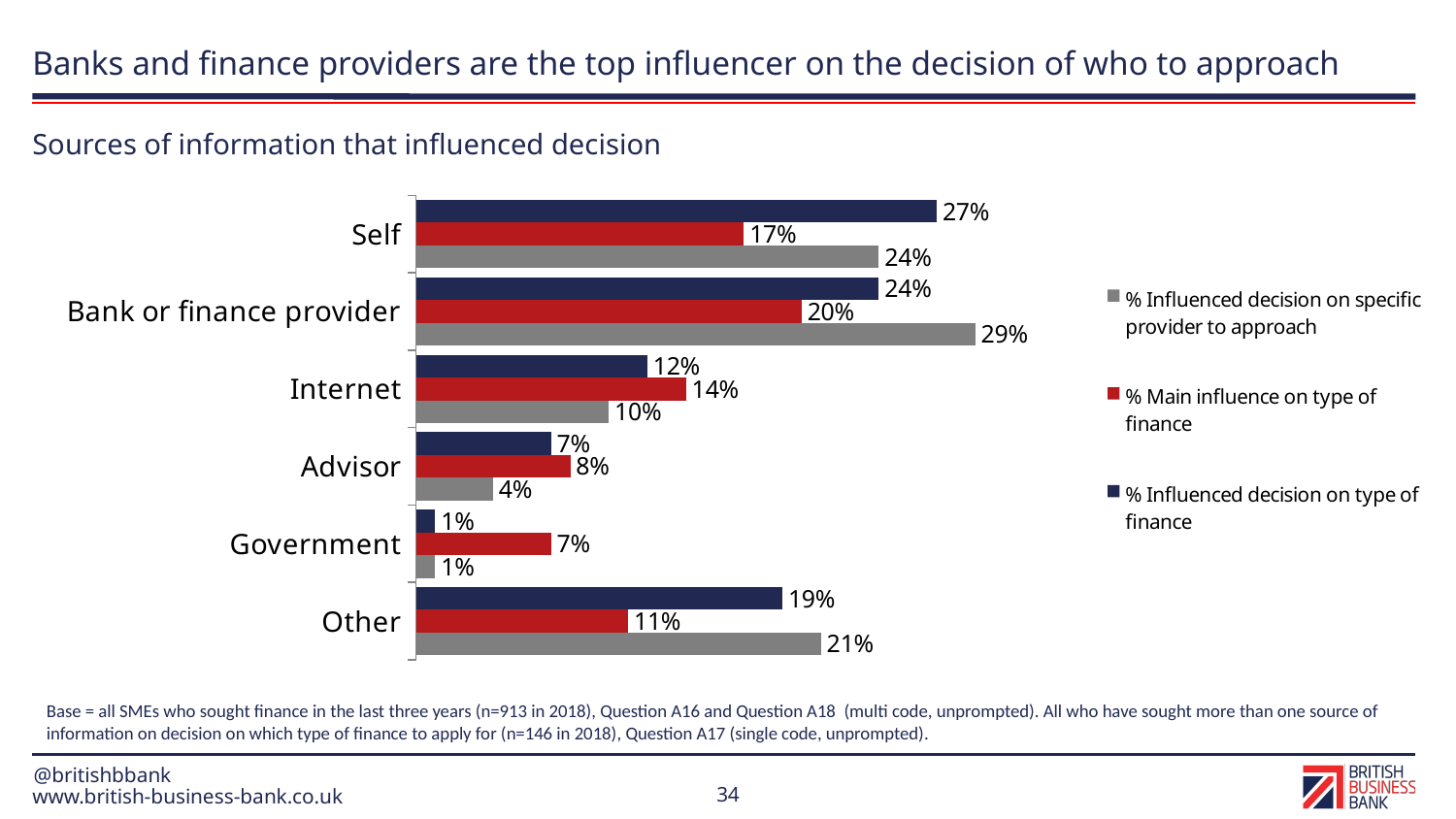
How many series does the legend list? 3 What kind of chart is shown on the slide? Bar chart What is the value for Advisor in the '% Influenced decision on specific provider to approach' series? 4% Which category has the lowest value in the '% Main influence on type of finance' series? Government For Other, which is larger: the '% Influenced decision on specific provider to approach' value or the '% Main influence on type of finance' value? % Influenced decision on specific provider to approach What is the difference between the '% Influenced decision on type of finance' values for Self and Bank or finance provider? 3% Which category has the highest value in the '% Influenced decision on specific provider to approach' series? Bank or finance provider What is the title of the chart? Sources of information that influenced decision What is the value for Internet in the '% Main influence on type of finance' series? 14% What is the value for Bank or finance provider in the '% Influenced decision on specific provider to approach' series? 29% What is the value for Self in the '% Influenced decision on type of finance' series? 27% How many categories are shown on the chart? 6